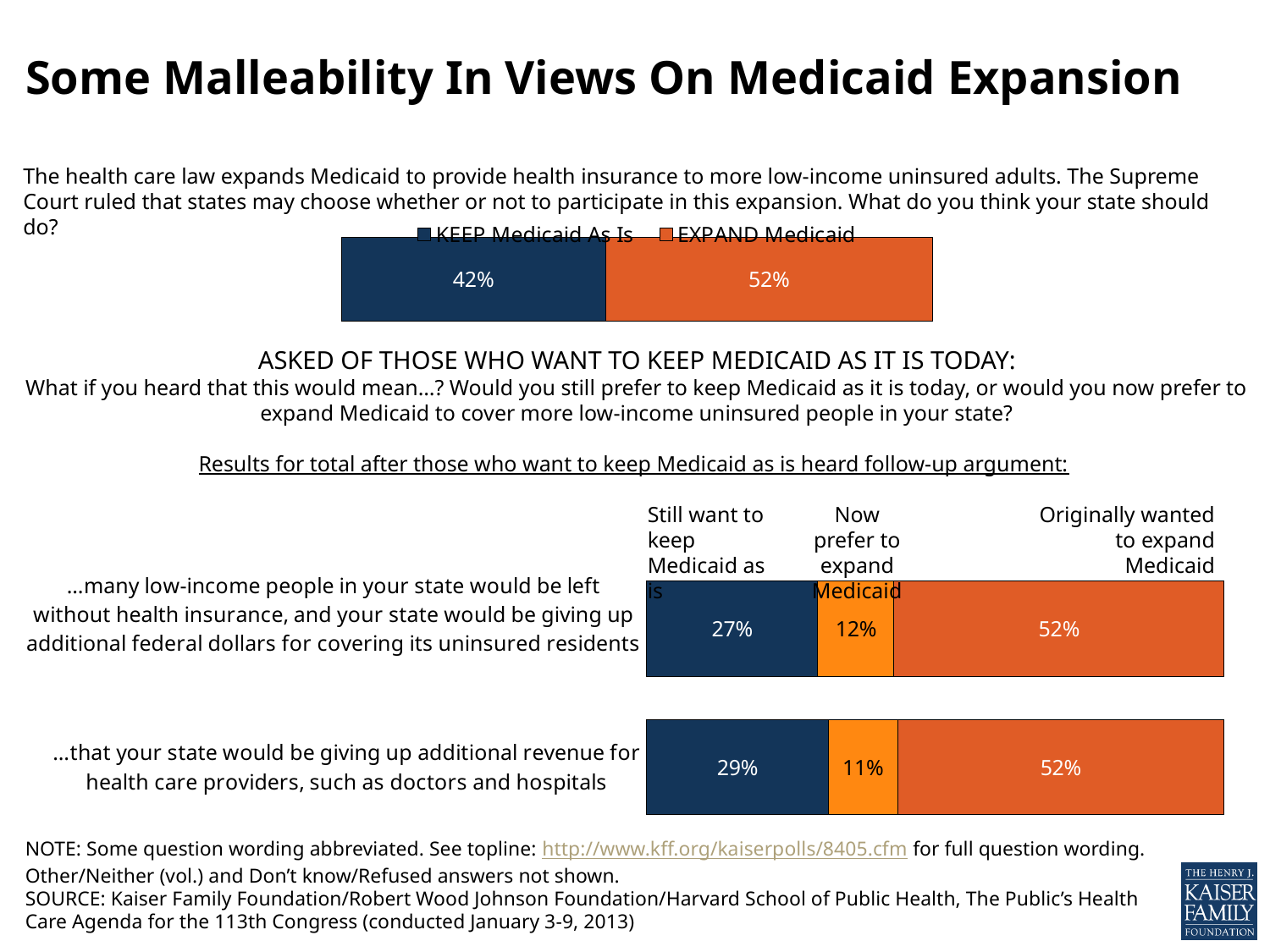
How many series does the legend of the top chart list? 2 What kind of chart is used in the bottom chart showing results after the follow-up arguments? Stacked bar chart In the top chart, what is the difference between the EXPAND Medicaid share and the KEEP Medicaid As Is share? 10 percentage points In the bottom chart, what percentage now prefer to expand Medicaid after hearing that many low-income people would be left without health insurance? 12% In the top chart, what percentage say their state should KEEP Medicaid as is? 42% In the top chart, what percentage say their state should EXPAND Medicaid? 52% In the bottom chart, what percentage now prefer to expand Medicaid after hearing that the state would give up additional revenue for health care providers? 11% In the bottom chart, what percentage originally wanted to expand Medicaid in each bar? 52% In the bottom chart, what percentage still want to keep Medicaid as is after hearing that many low-income people would be left without health insurance? 27% In the top chart, which option has the larger share: KEEP Medicaid As Is or EXPAND Medicaid? EXPAND Medicaid In the bottom chart, what is the total of the three segments for the bar about giving up additional revenue for health care providers? 92% In the bottom chart, how many bars (follow-up arguments) are shown? 2